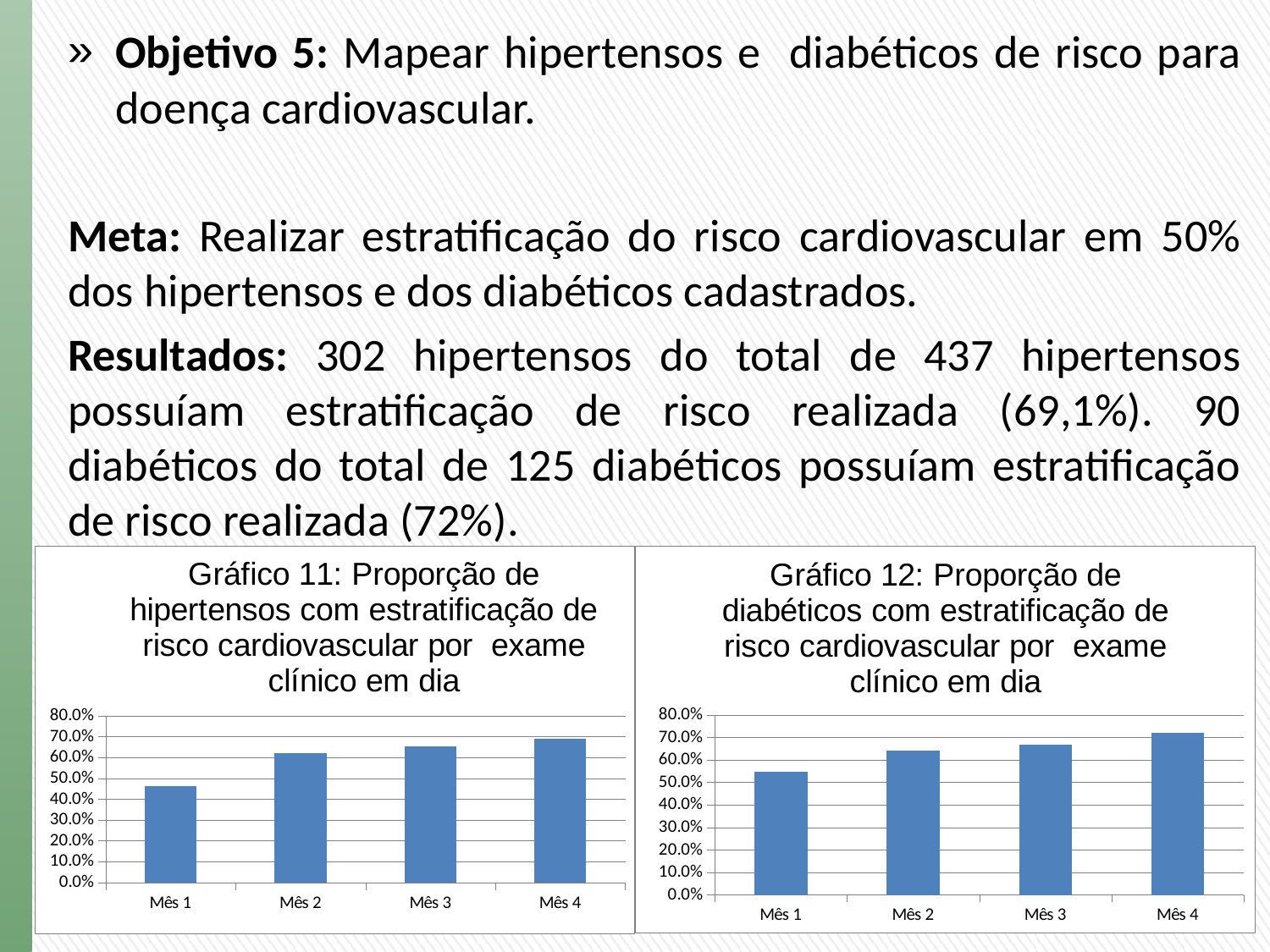
In Gráfico 11, which month has the lowest proportion? Mês 1 In Gráfico 12, which month has the highest proportion? Mês 4 In Gráfico 11, is the value for Mês 1 greater or less than 50.0%? less In Gráfico 12, is the value for Mês 1 greater or less than 60.0%? less How many categories are shown on the x axis of Gráfico 12? 4 What is the title of the chart on the right side of the slide? Gráfico 12: Proporção de diabéticos com estratificação de risco cardiovascular por exame clínico em dia In Gráfico 11, which month has the highest proportion? Mês 4 In Gráfico 11, do the values rise or fall from Mês 1 to Mês 4? rise What kind of chart is Gráfico 11? bar chart In Gráfico 12, which month has the lowest proportion? Mês 1 In Gráfico 12, is the value for Mês 4 greater or less than 70.0%? greater In Gráfico 11, which is larger, the value for Mês 1 or the value for Mês 2? Mês 2